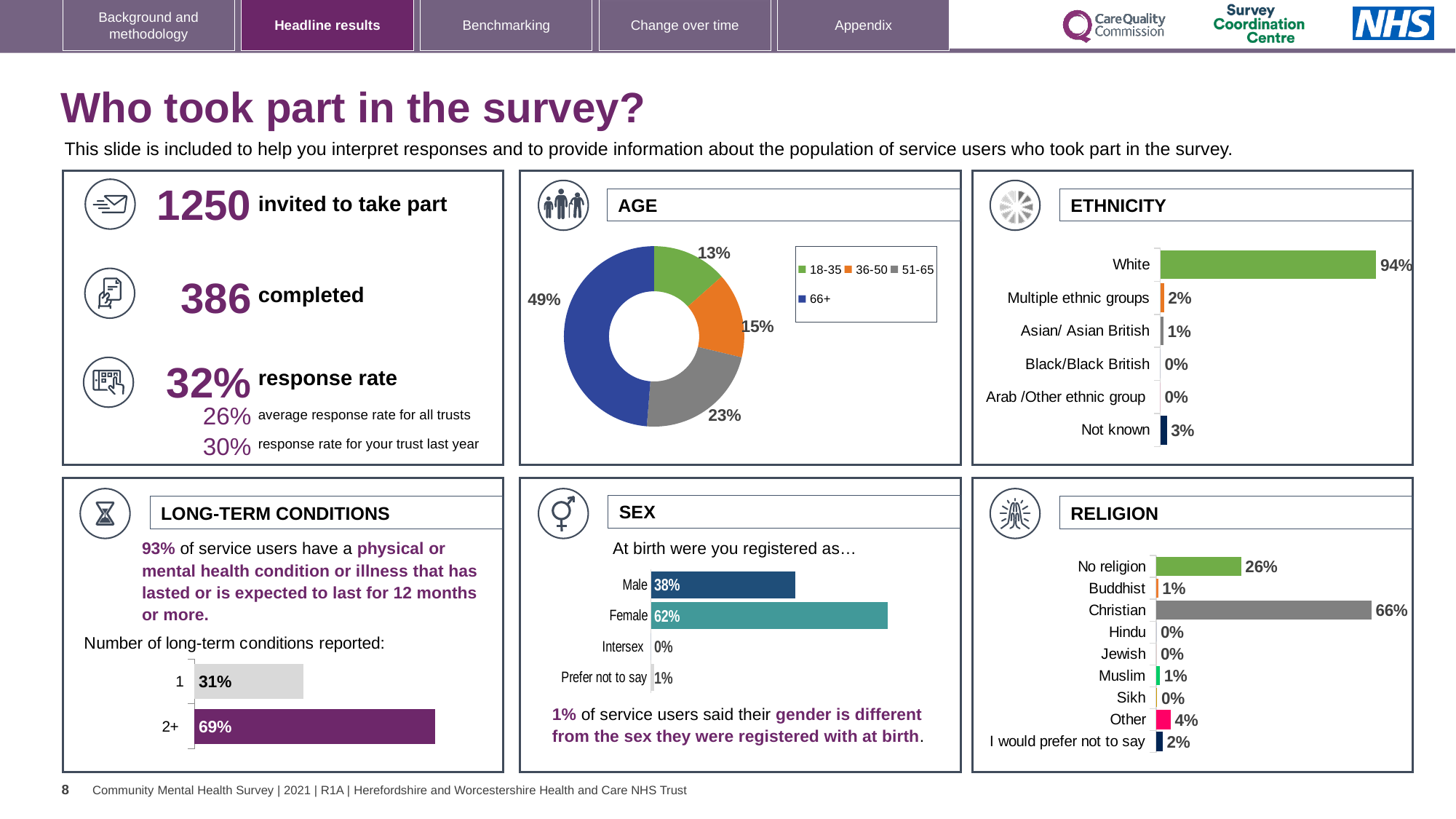
How many categories are shown in the RELIGION chart? 9 In the ETHNICITY chart, what is the value for White? 94% In the ETHNICITY chart, what is the difference between White and Not known? 91% What kind of chart is the AGE chart? Donut chart In the RELIGION chart, which category has the highest value? Christian In the SEX chart, what is the difference between Female and Male? 24% In the LONG-TERM CONDITIONS chart, what percentage reported 2+ conditions? 69% In the SEX chart, which is larger, Male or Female? Female How many entries does the legend of the AGE chart list? 4 In the AGE chart, which age group has the smallest share? 18-35 In the AGE chart, what share of respondents were aged 66+? 49% How many categories are shown in the ETHNICITY chart? 6